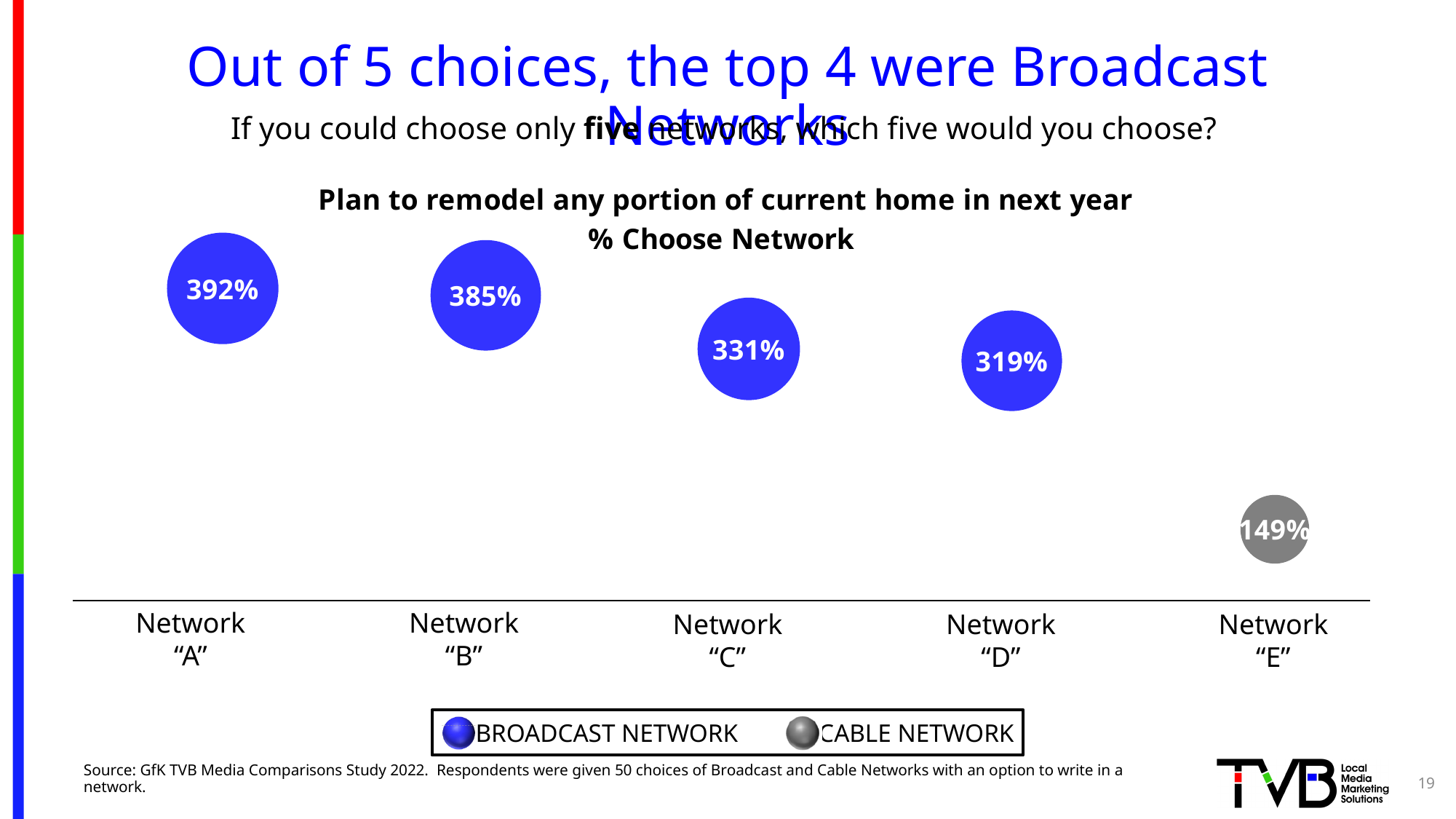
Which network has the lowest value? Network "E" What is the difference between the values for Network "A" and Network "B"? 7% Which network is shown as a Cable Network in the chart? Network "E" Which network has the highest value? Network "A" What is the difference between the values for Network "D" and Network "E"? 170% How many categories does the legend list? 2 What is the value for Network "A"? 392% What is the value for Network "E"? 149% Which is larger, the value for Network "C" or Network "D"? Network "C" What is the value for Network "C"? 331% Do the values rise or fall from Network "A" to Network "E"? fall How many networks are shown in the chart? 5